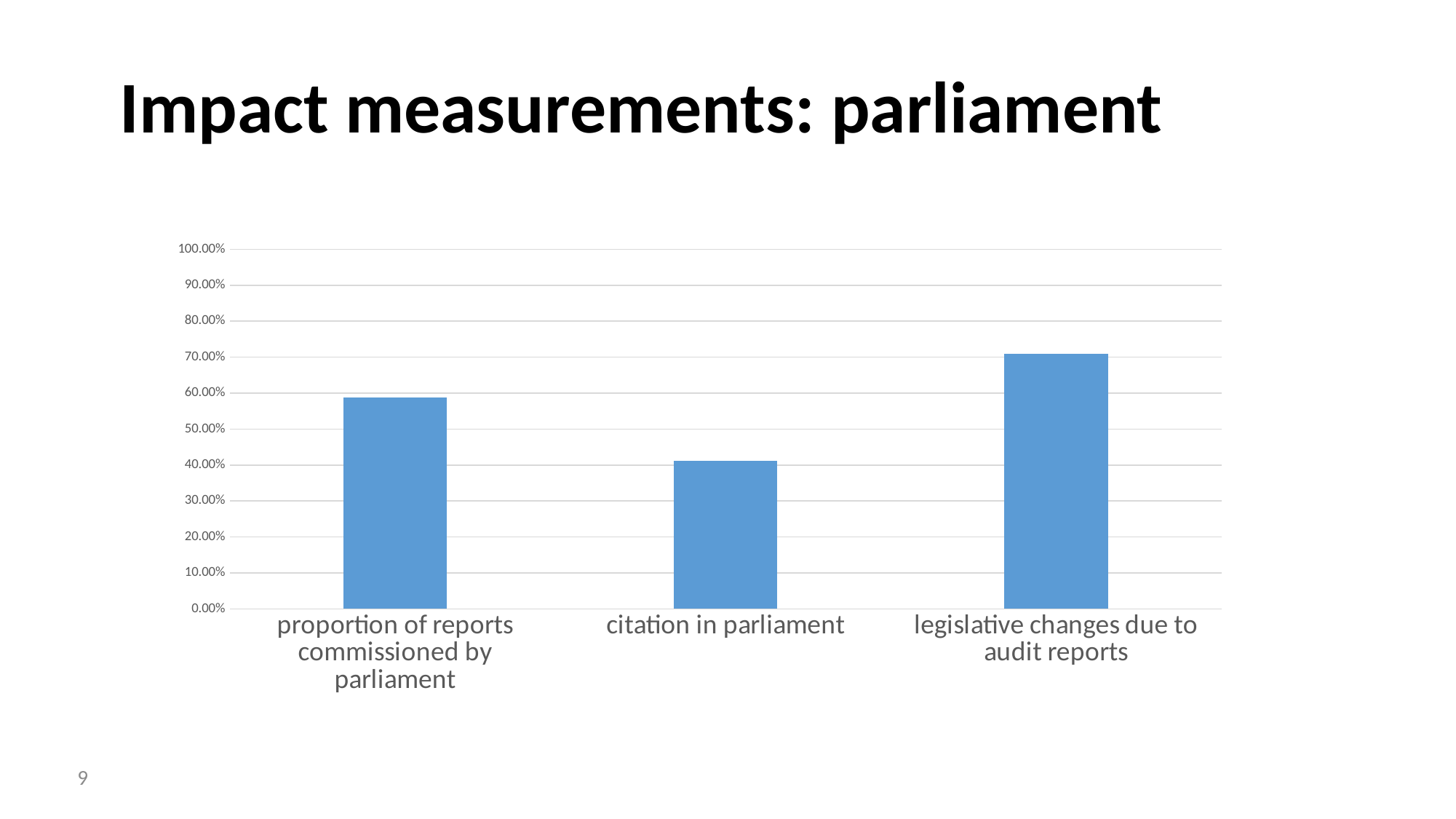
Is the value for legislative changes due to audit reports greater or less than 60.00%? greater What is the title of the slide containing the chart? Impact measurements: parliament What kind of chart is shown on the slide? bar chart Which is larger: the value for citation in parliament or the value for legislative changes due to audit reports? legislative changes due to audit reports Which is larger: the value for proportion of reports commissioned by parliament or the value for citation in parliament? proportion of reports commissioned by parliament Which category has the lowest value? citation in parliament Which category has the highest value? legislative changes due to audit reports Is the value for proportion of reports commissioned by parliament greater or less than 50.00%? greater Is the value for citation in parliament greater or less than 50.00%? less How many categories are plotted in the chart? 3